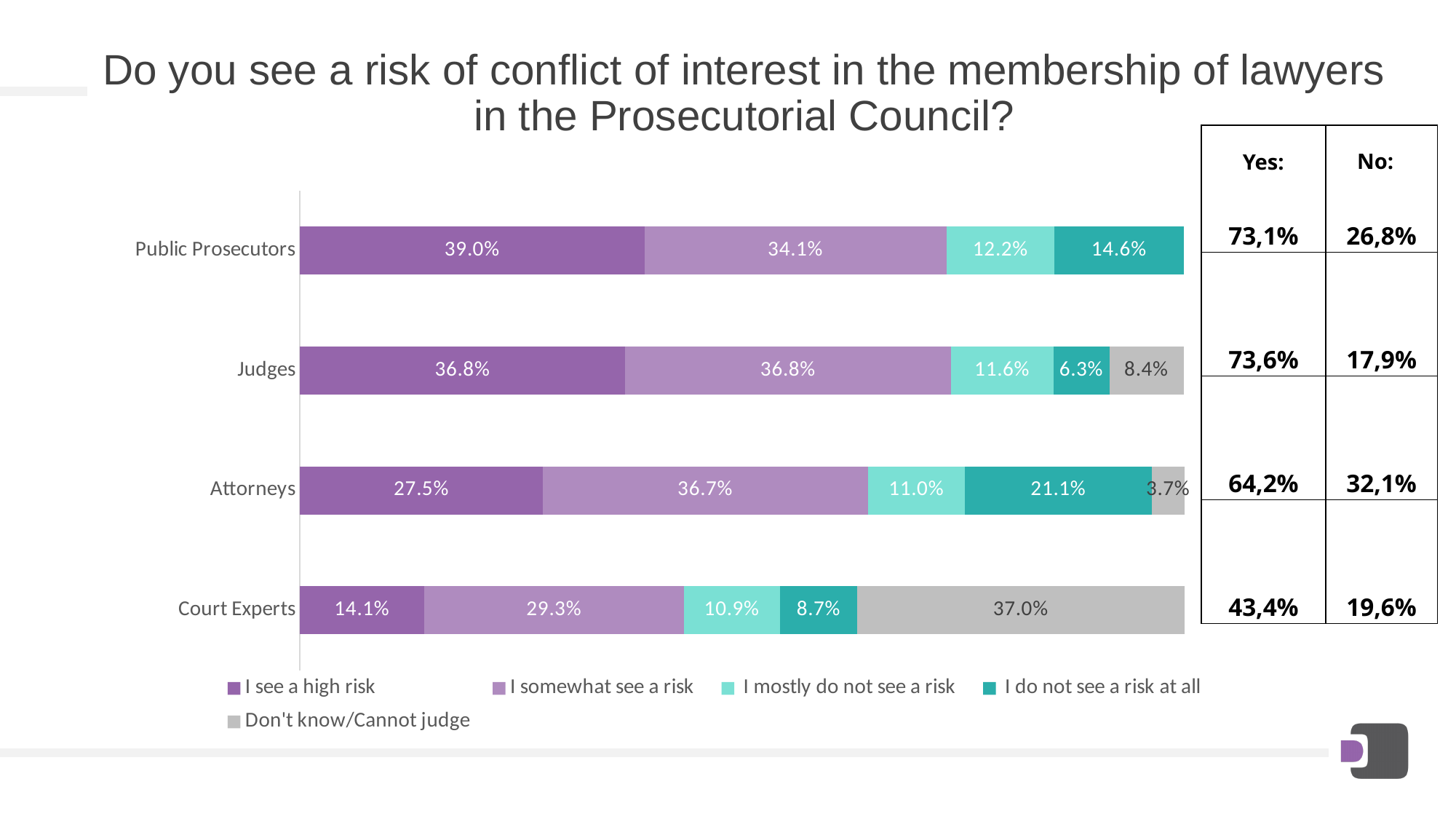
How many series does the legend list? 5 Which group has the highest share of 'I see a high risk' responses? Public Prosecutors What is the difference between the 'I see a high risk' shares of Public Prosecutors and Court Experts? 24.9% What is the combined share of 'I see a high risk' and 'I somewhat see a risk' for Attorneys? 64.2% How many respondent groups are shown on the chart? 4 What percentage of Court Experts answered 'Don't know/Cannot judge'? 37.0% Which is larger: the 'I do not see a risk at all' share for Attorneys or for Judges? Attorneys What percentage of Public Prosecutors say 'I see a high risk'? 39.0% What percentage of Judges say 'I mostly do not see a risk'? 11.6% What kind of chart is shown on the slide? Stacked bar chart Which group has the lowest share of 'I see a high risk' responses? Court Experts What percentage of Attorneys say 'I do not see a risk at all'? 21.1%